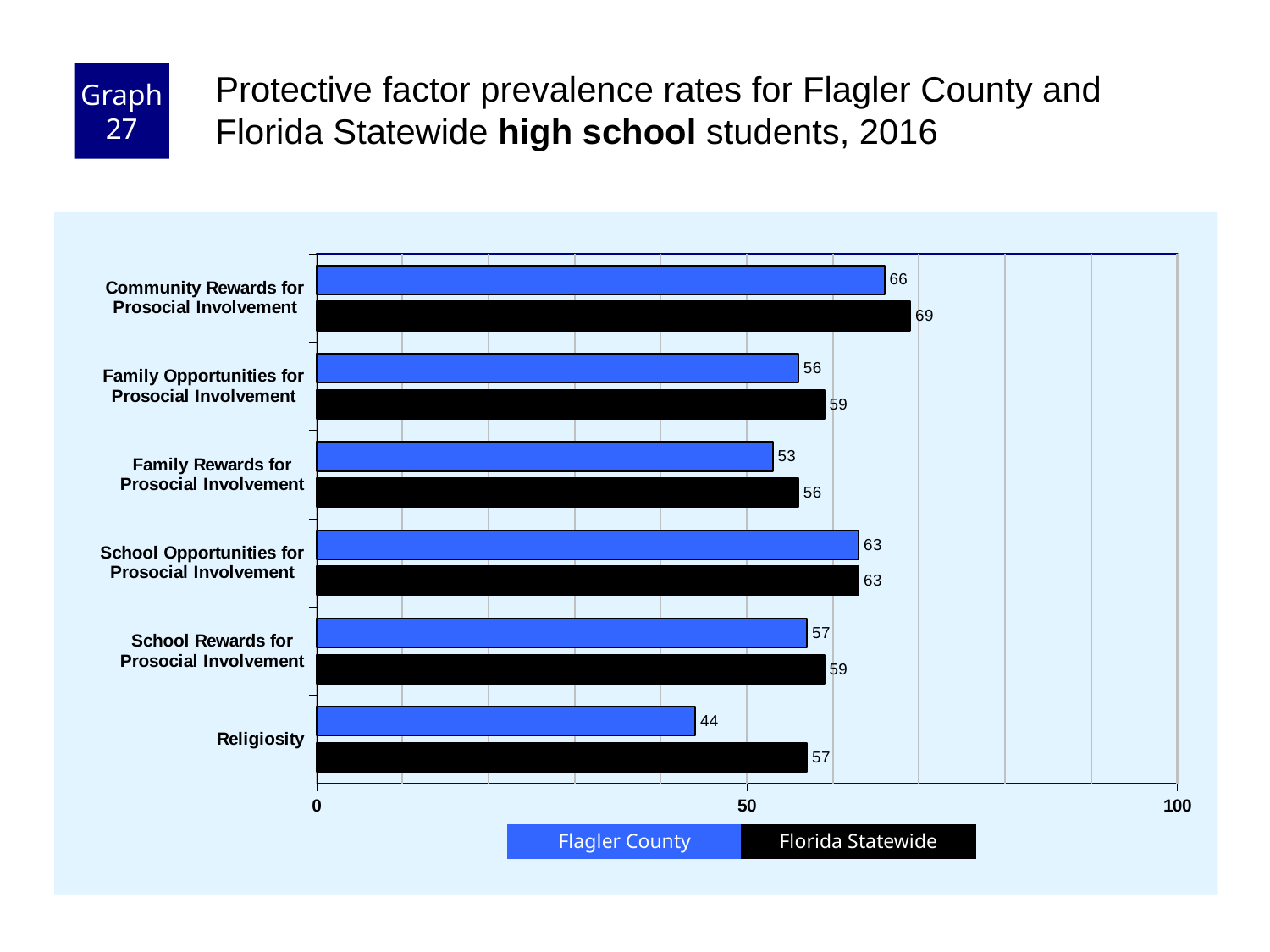
Which category has the lowest Flagler County value? Religiosity What is the Flagler County value for Family Rewards for Prosocial Involvement? 53 Which is larger for Family Opportunities for Prosocial Involvement: the Flagler County value or the Florida Statewide value? Florida Statewide What is the Florida Statewide value for Religiosity? 57 How many series does the legend list? 2 Is the Flagler County value for Religiosity greater or less than 50? less Which series is shown in black? Florida Statewide What is the difference between the Florida Statewide and Flagler County values for Religiosity? 13 What kind of chart is shown on the slide? bar chart Which category has the highest Florida Statewide value? Community Rewards for Prosocial Involvement What is the Flagler County value for Community Rewards for Prosocial Involvement? 66 How many categories are shown on the chart? 6